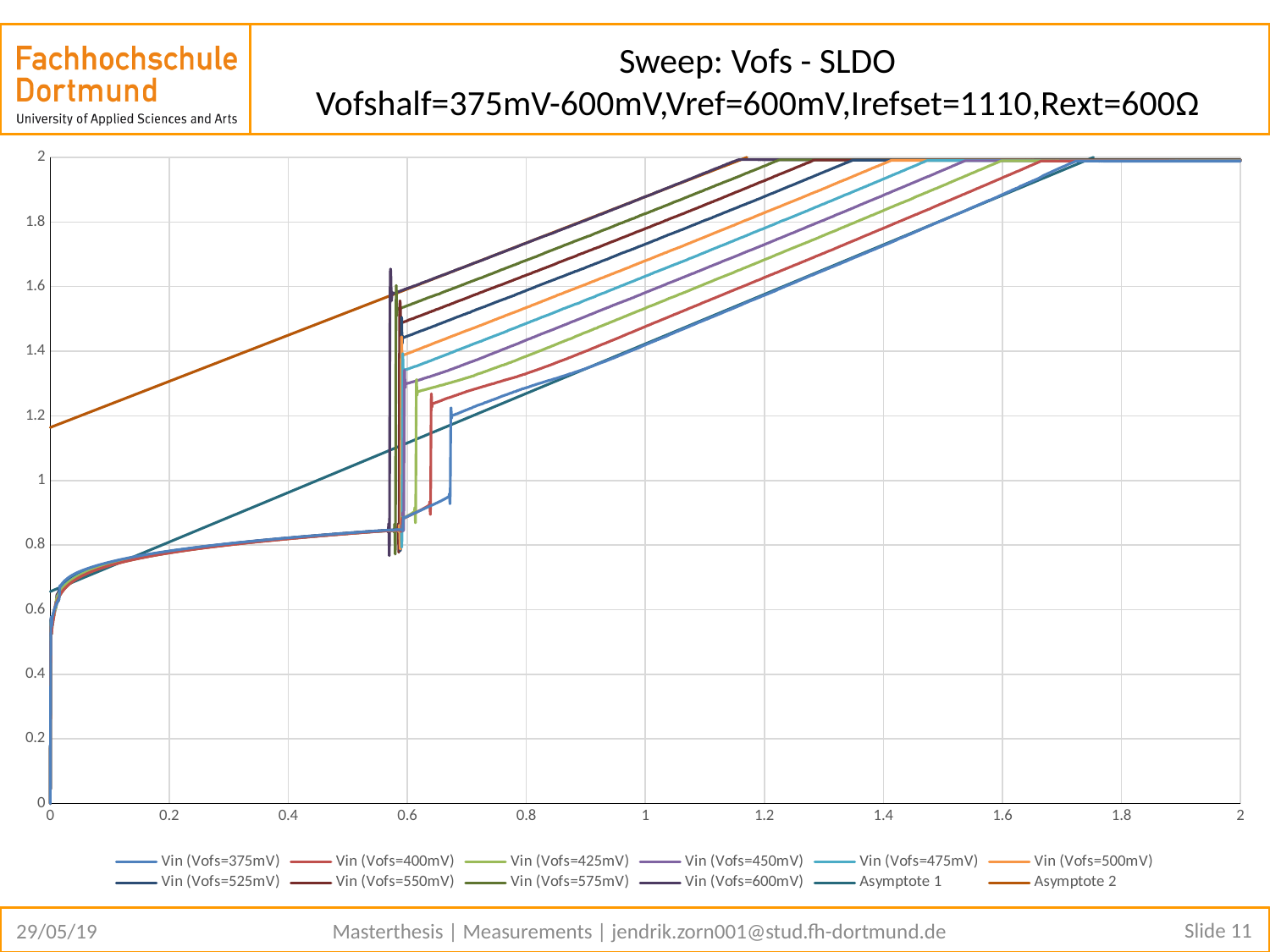
What is the first line of the chart title? Sweep: Vofs - SLDO How many series does the legend list? 12 What kind of chart is shown on the slide? line chart Which Vin series reaches the value 2 at the smallest x? Vin (Vofs=600mV) At x = 0.2, which is larger: Asymptote 1 or Asymptote 2? Asymptote 2 Is the value of Vin (Vofs=375mV) at x = 1.0 greater or less than 1.6? less Does Asymptote 2 rise or fall as x increases? rise Is the value of Vin (Vofs=600mV) at x = 1.4 greater or less than 1.8? greater Is the value of Asymptote 2 at x = 0 greater or less than 1? greater What is the last entry in the legend? Asymptote 2 What is the highest tick value shown on the y axis? 2